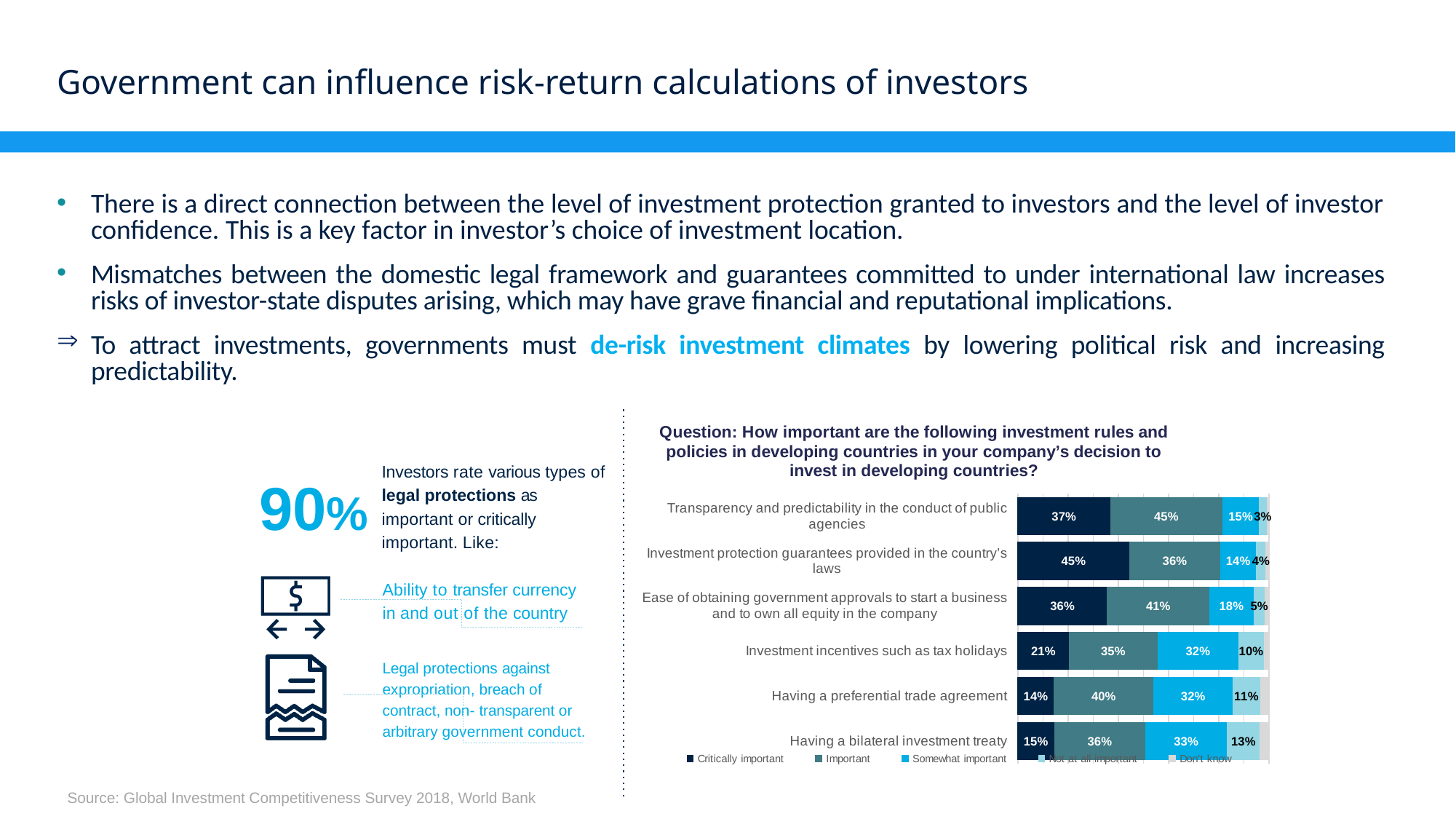
What is the difference between the 'Critically important' share for 'Transparency and predictability in the conduct of public agencies' and for 'Ease of obtaining government approvals to start a business and to own all equity in the company'? 1 percentage point Which category has the lowest share of 'Critically important' responses? Having a preferential trade agreement Which category has the highest share of 'Critically important' responses? Investment protection guarantees provided in the country's laws How many series does the chart legend list? 5 Which has a larger 'Somewhat important' share: 'Investment incentives such as tax holidays' or 'Transparency and predictability in the conduct of public agencies'? Investment incentives such as tax holidays What is the first series listed in the chart legend? Critically important What percentage of investors rated 'Having a preferential trade agreement' as not at all important? 11% What percentage of investors rated 'Investment protection guarantees provided in the country's laws' as critically important? 45% How many investment rules and policies (categories) are shown in the chart? 6 What type of chart is shown on the slide? Stacked bar chart What percentage of investors rated 'Having a bilateral investment treaty' as somewhat important? 33% What is the difference between the 'Important' share for 'Transparency and predictability in the conduct of public agencies' and for 'Investment incentives such as tax holidays'? 10 percentage points